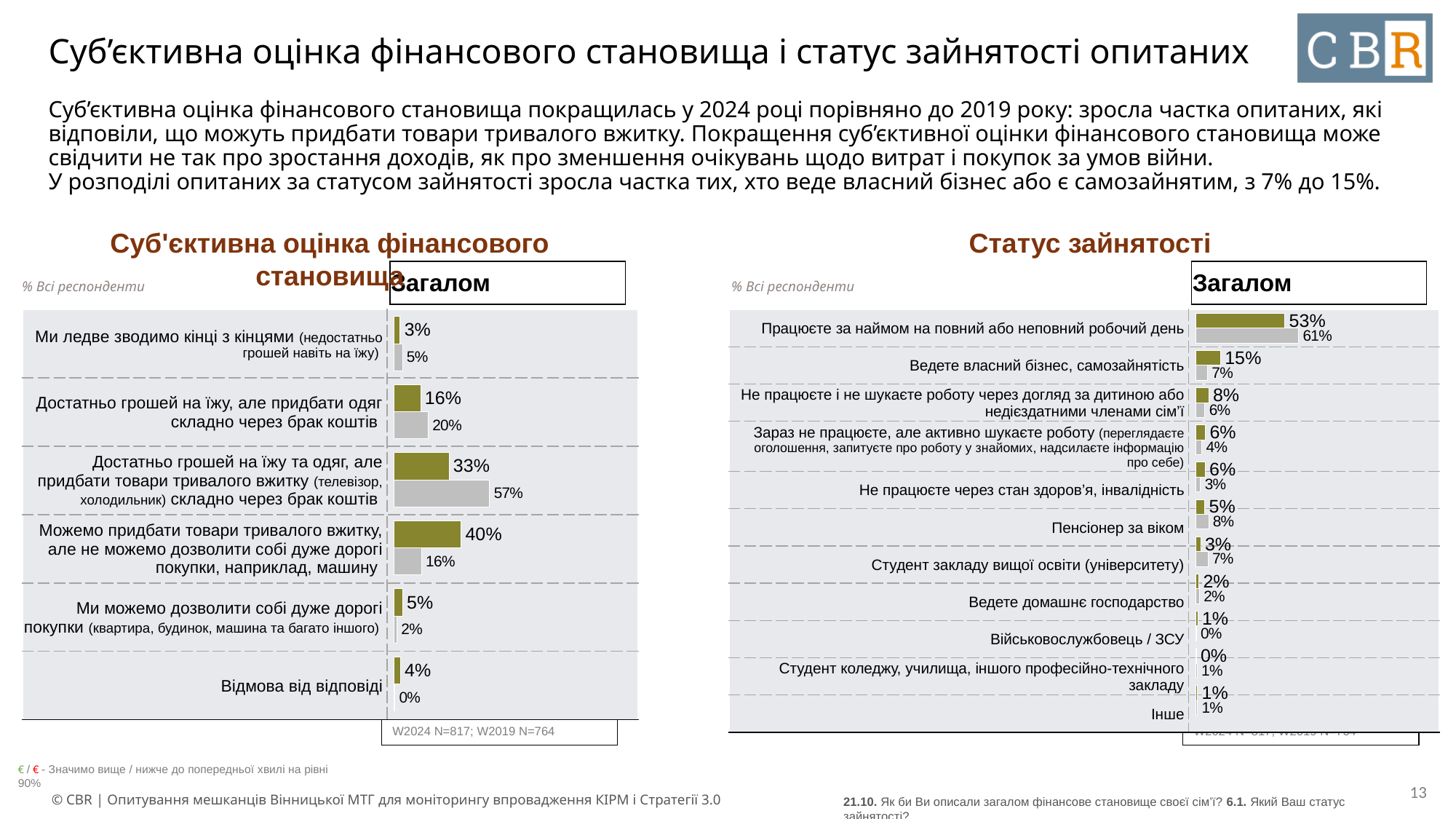
In the chart 'Суб'єктивна оцінка фінансового становища', what is the 2019 (grey bar) value for 'Достатньо грошей на їжу та одяг, але придбати товари тривалого вжитку складно через брак коштів'? 57% In the chart 'Суб'єктивна оцінка фінансового становища', what is the 2024 (olive bar) value for 'Можемо придбати товари тривалого вжитку, але не можемо дозволити собі дуже дорогі покупки, наприклад, машину'? 40% What type of chart is 'Статус зайнятості'? Bar chart In the chart 'Суб'єктивна оцінка фінансового становища', what is the difference between the 2019 and 2024 values for 'Достатньо грошей на їжу та одяг, але придбати товари тривалого вжитку складно через брак коштів'? 24 percentage points In the chart 'Статус зайнятості', what is the 2019 (grey bar) value for 'Пенсіонер за віком'? 8% In the chart 'Статус зайнятості', which category has the highest 2024 (olive bar) value? Працюєте за наймом на повний або неповний робочий день How many categories are shown in the chart 'Статус зайнятості'? 11 What are the sample sizes noted below the chart 'Суб'єктивна оцінка фінансового становища'? W2024 N=817; W2019 N=764 In the chart 'Статус зайнятості', what is the 2024 (olive bar) value for 'Працюєте за наймом на повний або неповний робочий день'? 53% In the chart 'Суб'єктивна оцінка фінансового становища', for 'Достатньо грошей на їжу, але придбати одяг складно через брак коштів', which is larger: the 2024 value or the 2019 value? 2019 (20%) In the chart 'Статус зайнятості', by how many percentage points does the 2024 value for 'Ведете власний бізнес, самозайнятість' exceed the 2019 value? 8 percentage points How many categories are shown in the chart 'Суб'єктивна оцінка фінансового становища'? 6